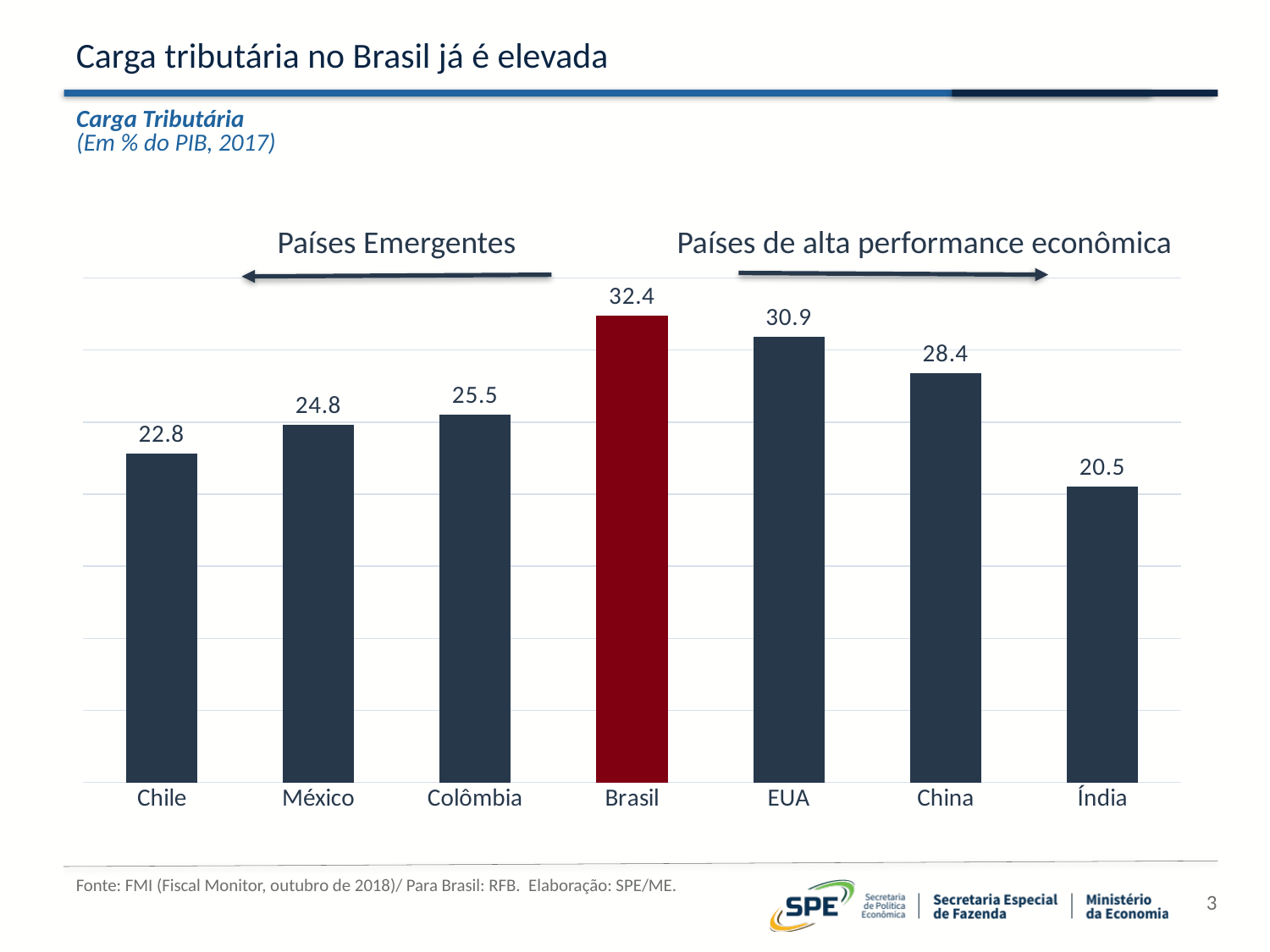
How many countries are shown in the chart? 7 What is the value shown for Chile? 22.8 Which country has the highest value in the chart? Brasil Which country has the lowest value in the chart? Índia Which bar is highlighted in a different colour (dark red) from the others? Brasil What is the difference between the values for Brasil and EUA? 1.5 Which has a larger value, EUA or China? EUA What type of chart is shown on the slide? Bar chart What is the tax burden value shown for Brasil? 32.4 Which has a larger value, Chile or Índia? Chile What is the value shown for China? 28.4 What is the difference between the values for Colômbia and México? 0.7